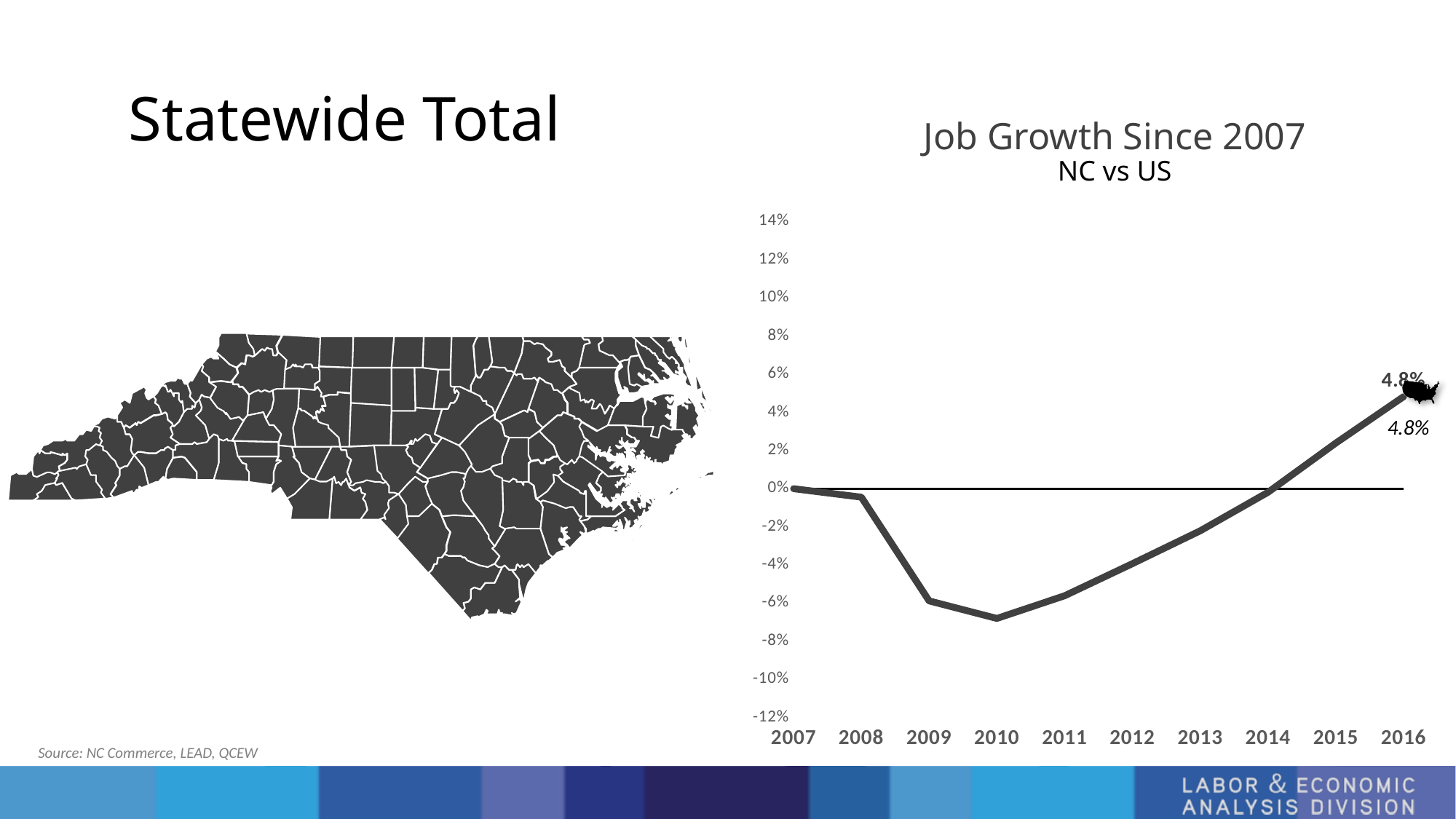
Is the value for 2015 greater or less than 0%? greater What is the job growth value shown for 2016? 4.8% Does the line rise or fall between 2007 and 2010? fall What is the title of the chart? Job Growth Since 2007 In which year is the job growth line at its lowest point? 2010 How many years are shown on the x axis of the chart? 10 What is the highest tick shown on the y axis? 14% Is the value for 2013 greater or less than -4%? greater Which year has the larger value, 2010 or 2016? 2016 What kind of chart is shown on the slide? line chart Is the value for 2009 greater or less than -4%? less Does the line rise or fall between 2010 and 2016? rise